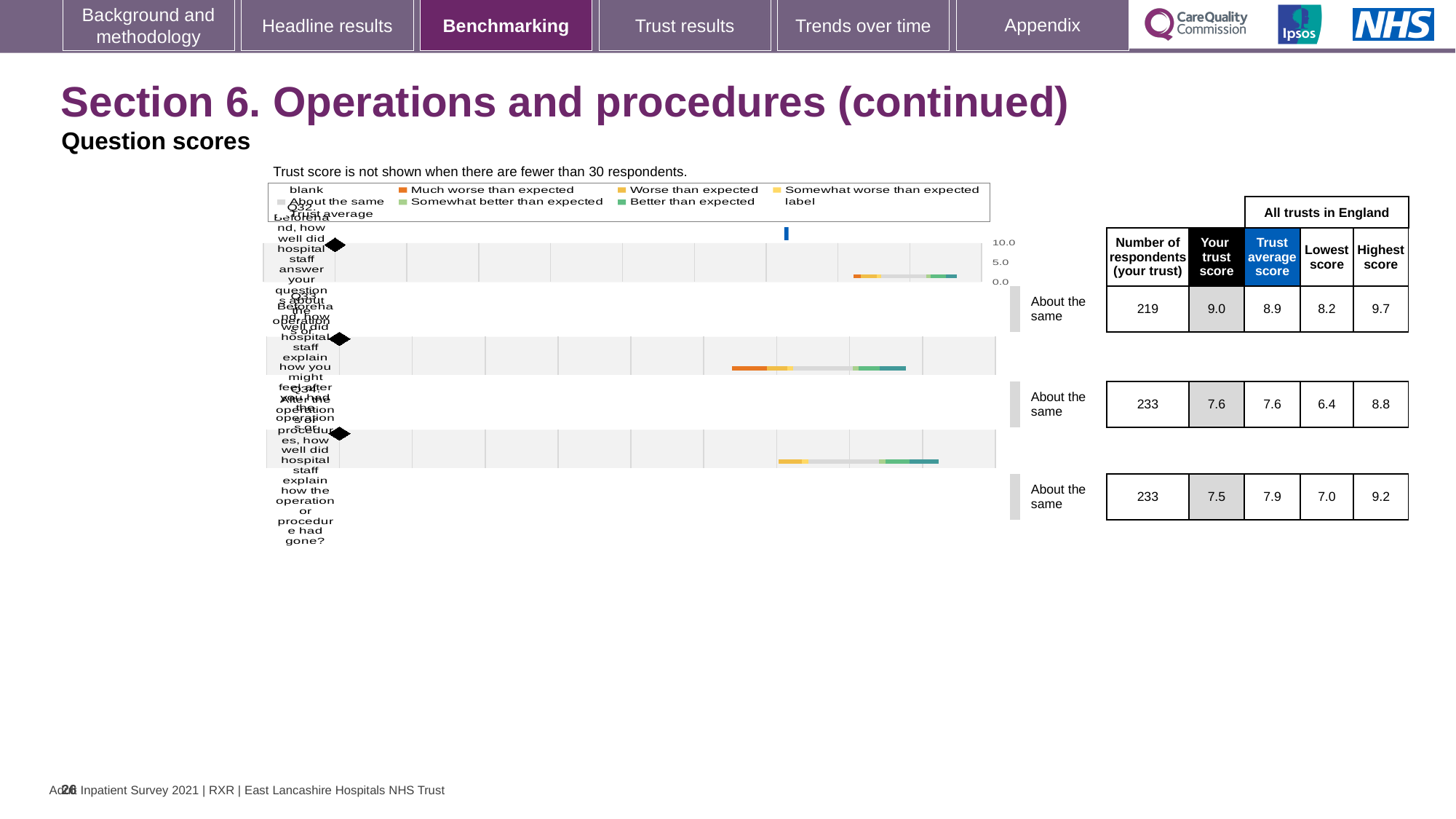
For the top chart (Q32), what is the difference between the highest score and the lowest score across all trusts in England? 1.5 How many question charts are shown on the slide? 3 For the middle chart (Q33), what is the lowest score among all trusts in England? 6.4 For the top chart (Q32), what is the 'Your trust score' value shown in the table? 9.0 For the bottom chart (Q34), what is the highest score among all trusts in England? 9.2 For the bottom chart (Q34), which is larger: your trust score or the trust average score? trust average score In the top chart (Q32), is the trust score marker greater or less than 5.0 on the axis? greater What benchmark category label is shown to the right of each of the three charts? About the same What type of chart is used to show the question scores on this slide? bar chart For the top chart (Q32), how many respondents does the table show for your trust? 219 Which of the three charts has the highest 'Your trust score'? the top chart (Q32) For the middle chart (Q33), what is the trust average score for all trusts in England? 7.6